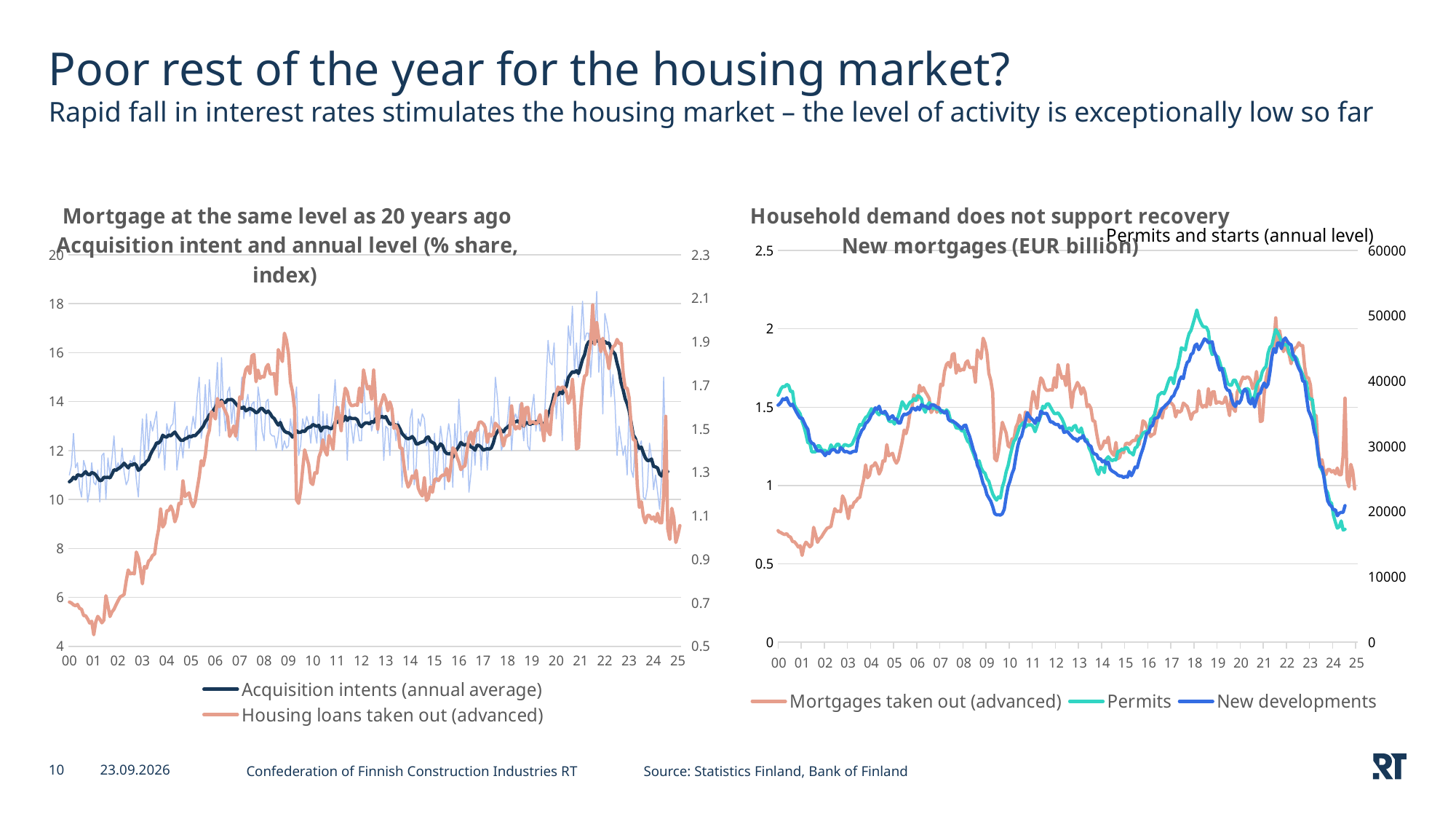
How many series does the legend of the right chart list? 3 In the left chart, is the value of 'Acquisition intents (annual average)' at the start of 2000 greater or less than 10? greater In the right chart, does 'Mortgages taken out (advanced)' rise or fall between 2000 and 2008? rise How many series does the legend of the left chart list? 2 What kind of chart is the left chart, 'Mortgage at the same level as 20 years ago'? Line chart In the left chart, does 'Acquisition intents (annual average)' rise or fall between 2022 and 2025? fall In the right chart, is the peak value of 'New developments' around 2018 greater or less than 40000? greater In the left chart, which series is shown in dark navy? Acquisition intents (annual average) What kind of chart is the right chart, 'Household demand does not support recovery'? Line chart In the right chart, which series is shown in dark blue? New developments In the right chart, is the value of 'Permits' at the end of 2024 greater or less than 20000? less